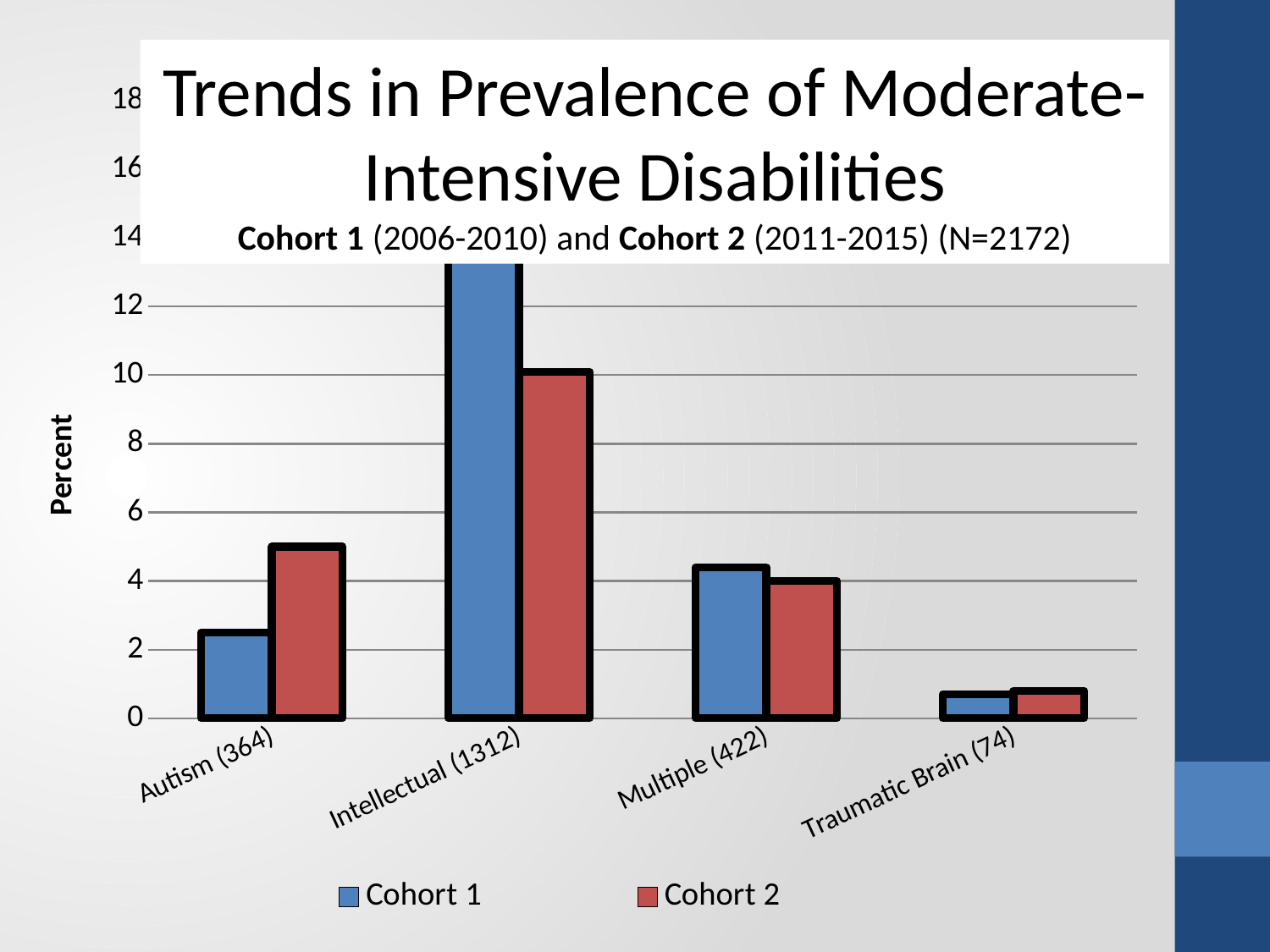
What is the label on the y axis? Percent Which category has the lowest Cohort 2 value? Traumatic Brain (74) Which category has the lowest Cohort 1 value? Traumatic Brain (74) For Autism (364), which is larger: the Cohort 1 value or the Cohort 2 value? Cohort 2 For Intellectual (1312), which is larger: the Cohort 1 value or the Cohort 2 value? Cohort 1 What kind of chart is shown on the slide? bar chart Which category has the highest Cohort 1 value? Intellectual (1312) Is the Cohort 2 value for Intellectual (1312) greater or less than 8? greater How many disability categories are shown on the x axis? 4 Is the Cohort 1 value for Autism (364) greater or less than 4? less How many series does the legend list? 2 Is the Cohort 1 value for Multiple (422) greater or less than 2? greater